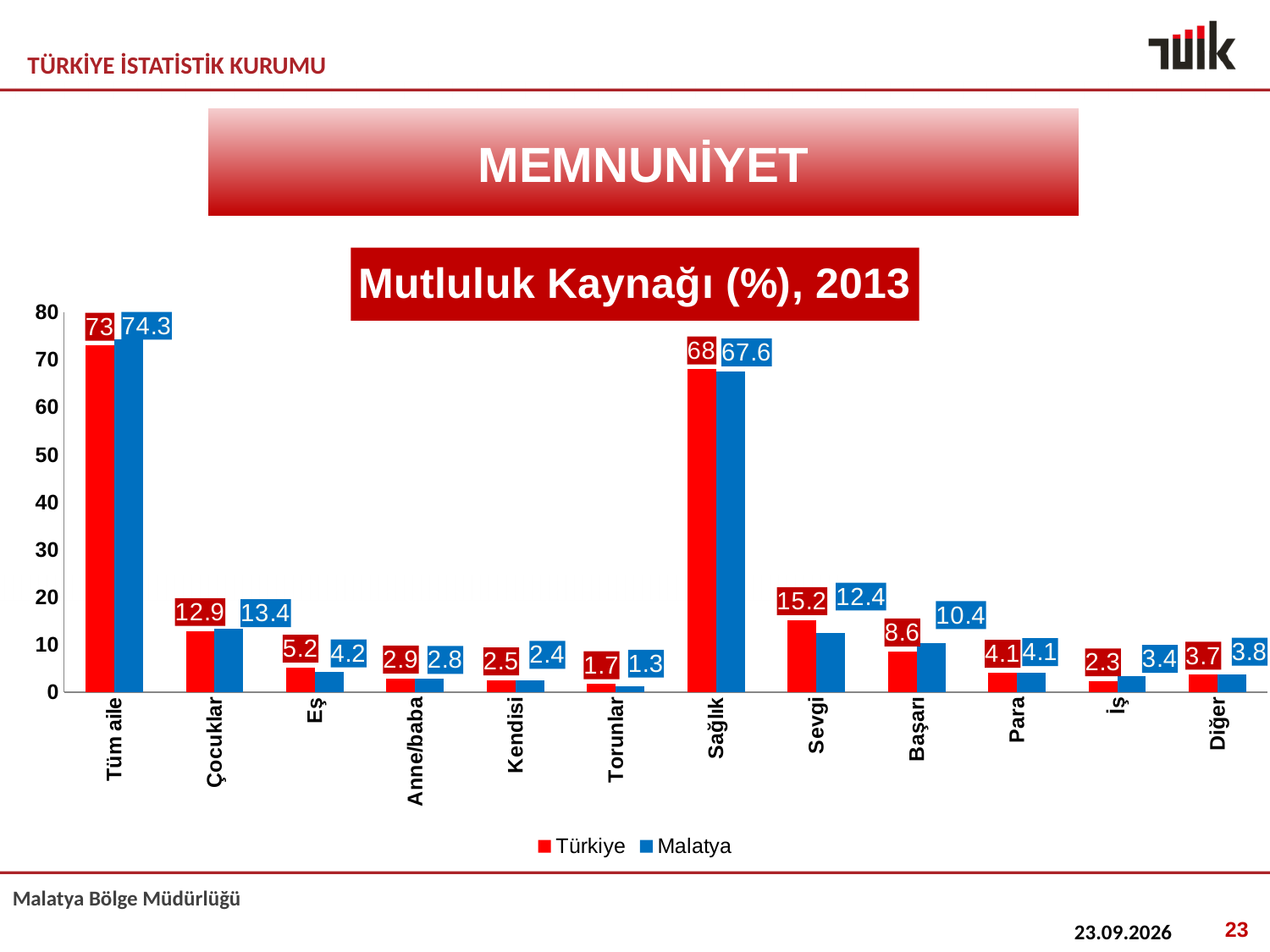
Which category has the lowest Türkiye value? Torunlar How many series does the legend list? 2 What is the Türkiye value for Sağlık? 68 What is the title of the chart? Mutluluk Kaynağı (%), 2013 Which is larger for Başarı, the Türkiye value or the Malatya value? Malatya What kind of chart is shown on the slide? Bar chart What is the Malatya value for Çocuklar? 13.4 What is the difference between the Malatya and Türkiye values for Sevgi? 2.8 What is the Malatya value for Başarı? 10.4 How many categories are shown on the x axis? 12 Which category has the highest Malatya value? Tüm aile Is the Türkiye value for Sağlık greater or less than 60? greater